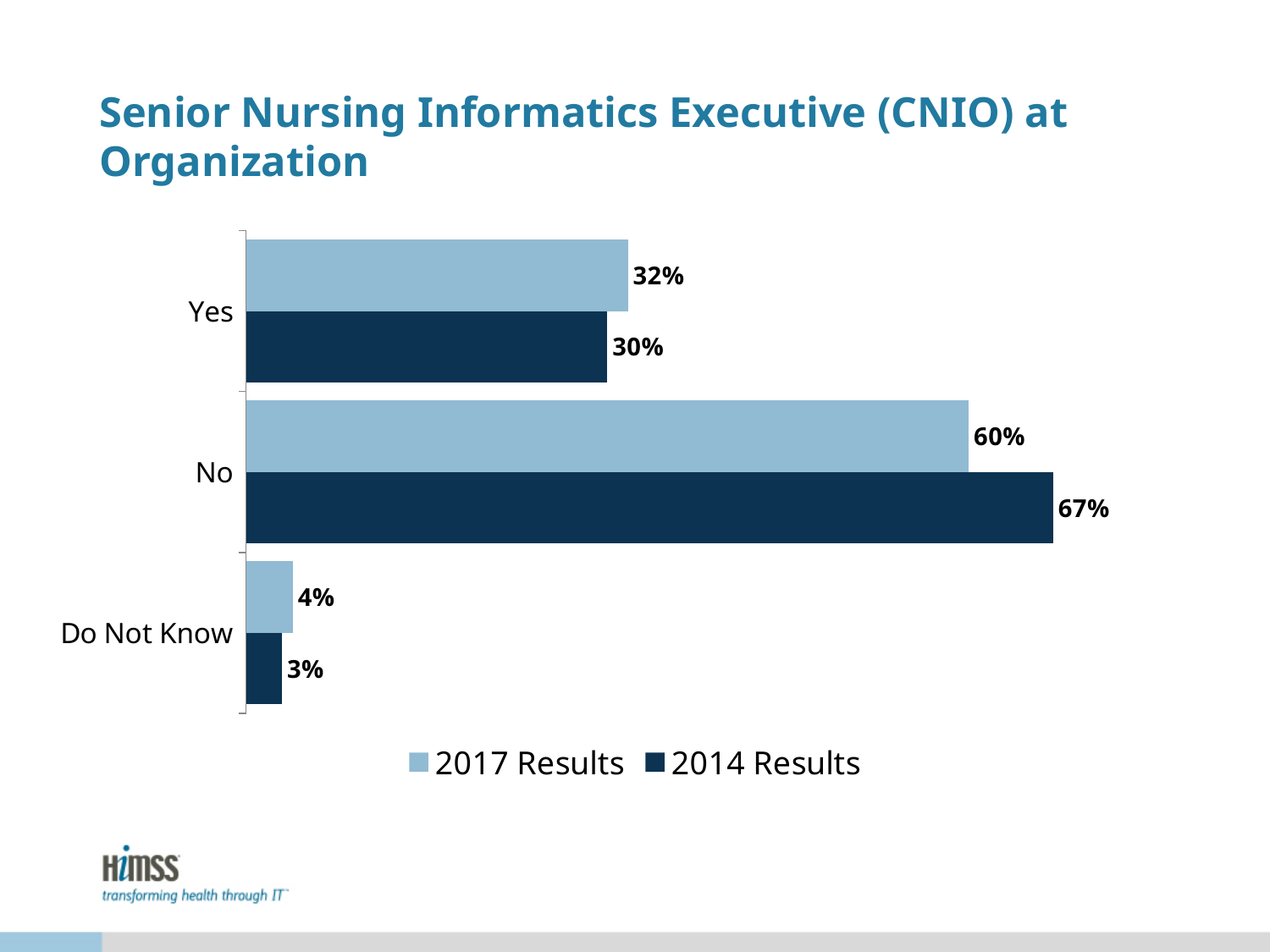
Which is larger for "Yes": the 2017 Results value or the 2014 Results value? 2017 Results What is the 2017 Results value for "Do Not Know"? 4% Which category has the lowest 2014 Results value? Do Not Know What is the 2017 Results value for "Yes"? 32% What is the title of the chart? Senior Nursing Informatics Executive (CNIO) at Organization How many categories are shown on the chart? 3 How many series does the legend list? 2 Which category has the highest 2017 Results value? No What is the 2014 Results value for "Yes"? 30% What kind of chart is shown on the slide? Bar chart What is the difference between the 2014 Results and 2017 Results values for "No"? 7% What is the 2014 Results value for "No"? 67%